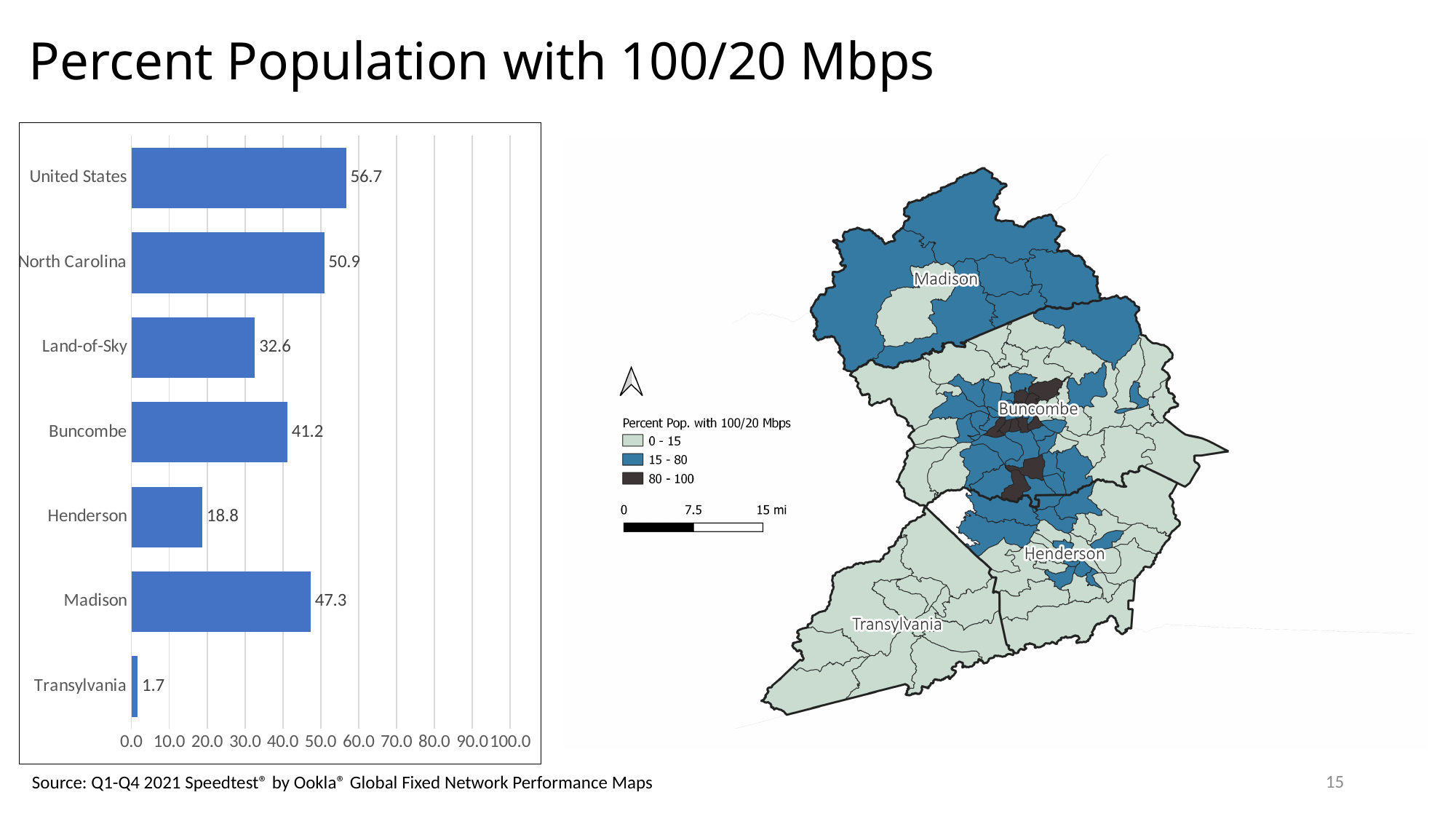
Is the value for Henderson in the bar chart greater or less than 20.0? less What is the value for Buncombe in the bar chart? 41.2 What is the difference between the values for Madison and Henderson in the bar chart? 28.5 What is the difference between the values for United States and Land-of-Sky in the bar chart? 24.1 How many ranges does the map legend list for Percent Pop. with 100/20 Mbps? 3 Which category has the lowest value in the bar chart? Transylvania Which category has the highest value in the bar chart? United States What kind of chart is shown on the left of the slide? bar chart What is the value for Transylvania in the bar chart? 1.7 What is the value for North Carolina in the bar chart? 50.9 Which has a larger value in the bar chart, Madison or Buncombe? Madison How many categories are shown in the bar chart? 7